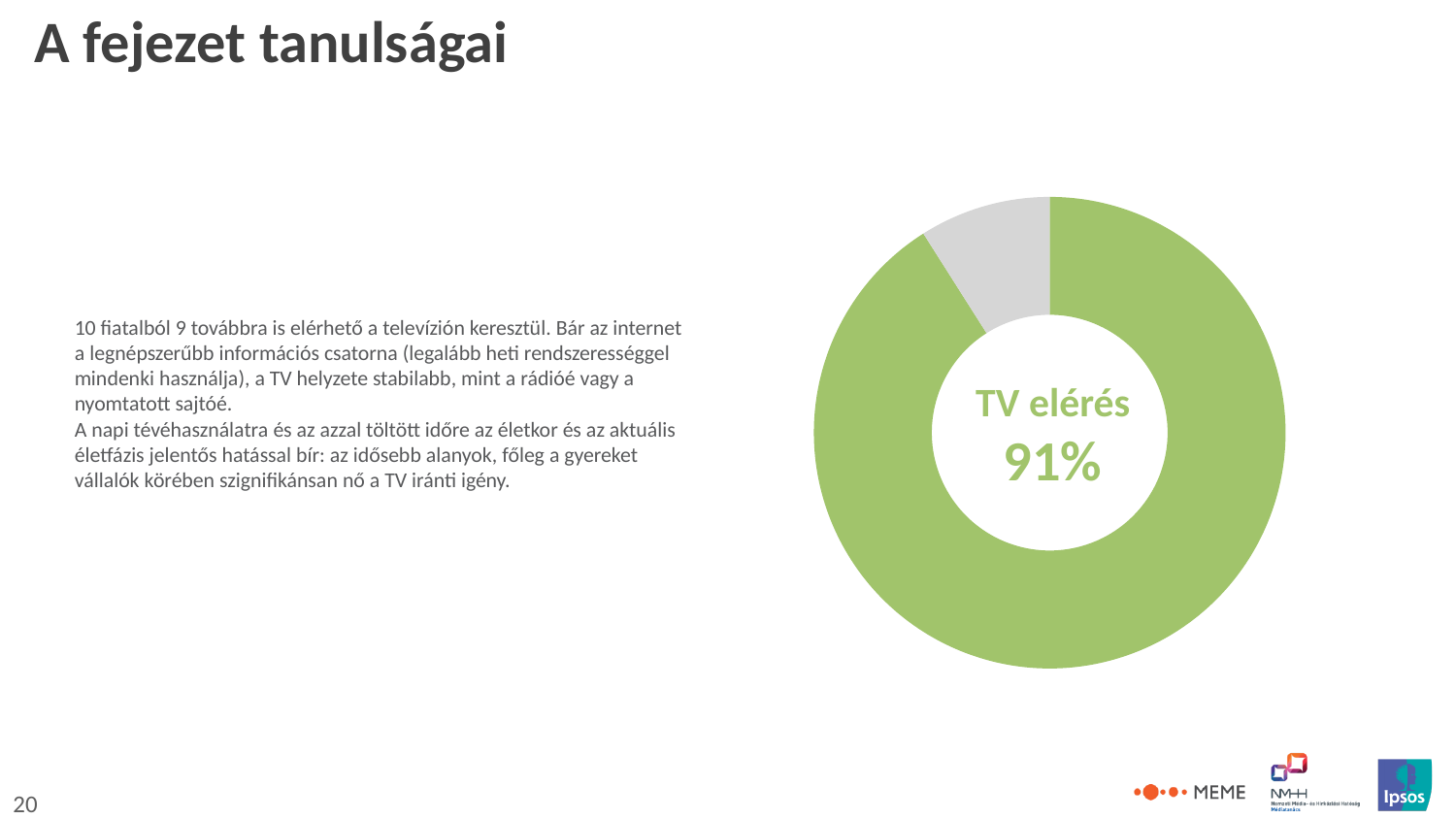
What label is written in the centre of the donut chart above the percentage? TV elérés What share of the donut does the green segment represent? 91% Which segment of the donut chart is larger, the green one or the grey one? The green one What value is printed in the centre of the donut chart? 91% What is the TV reach (TV elérés) shown on the chart? 91% What colour is the segment representing the 91% TV reach? Green How many segments does the donut chart have? 2 What kind of chart is shown on the slide? Donut (pie) chart